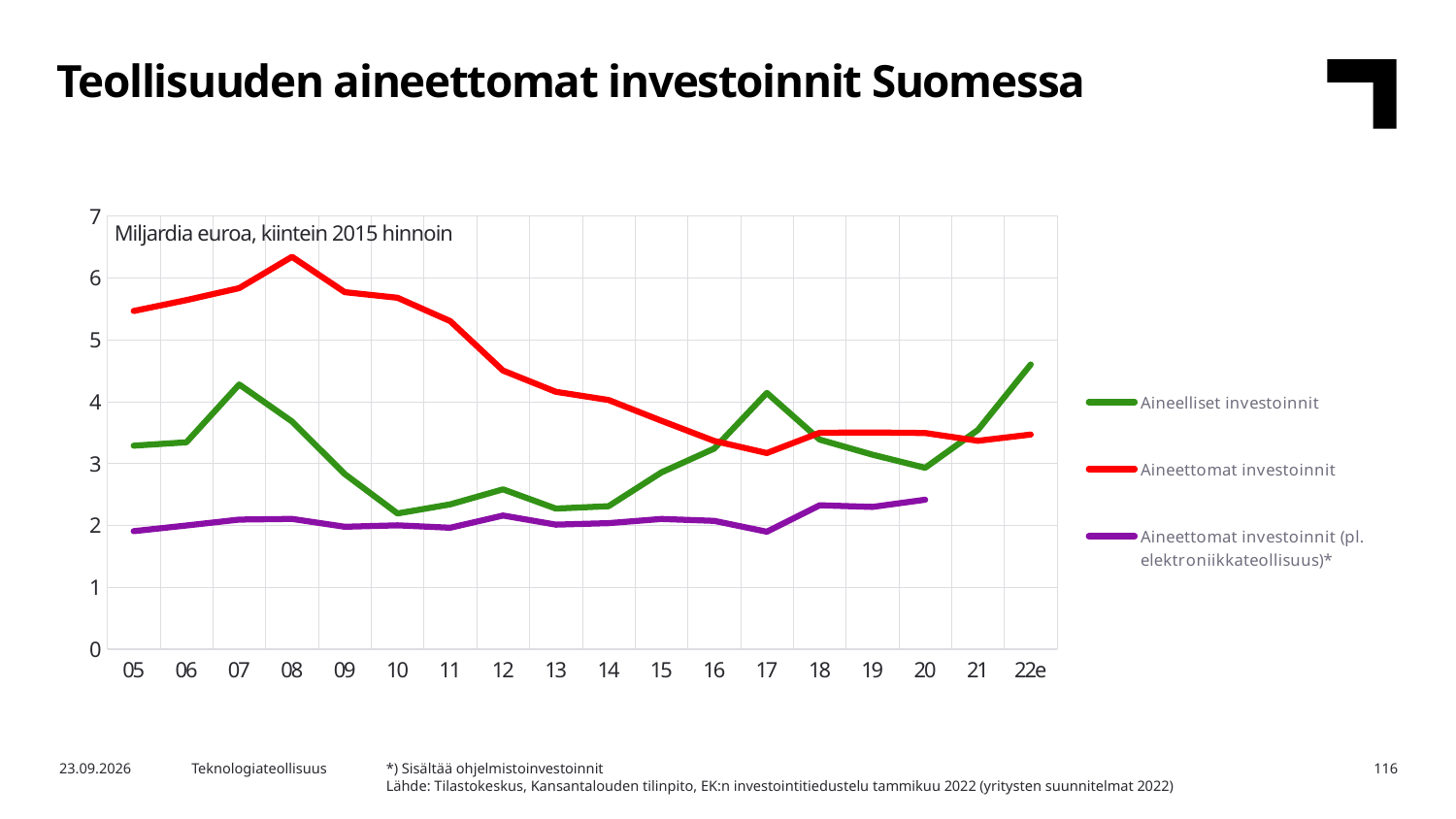
Is the value for Aineettomat investoinnit (pl. elektroniikkateollisuus)* in 17 greater or less than 2? less Is the value for Aineelliset investoinnit in 10 greater or less than 3? less In which year does the Aineelliset investoinnit series reach its highest value? 22e How many series does the legend list? 3 Is the value for Aineettomat investoinnit in 08 greater or less than 6? greater In which year does the Aineettomat investoinnit series reach its highest value? 08 How many categories are shown on the x axis? 18 In 17, which series has the larger value: Aineelliset investoinnit or Aineettomat investoinnit? Aineelliset investoinnit Does the Aineettomat investoinnit series rise or fall between 08 and 17? fall What unit is stated in the text inside the chart area? Miljardia euroa, kiintein 2015 hinnoin What kind of chart is shown on the slide? line chart